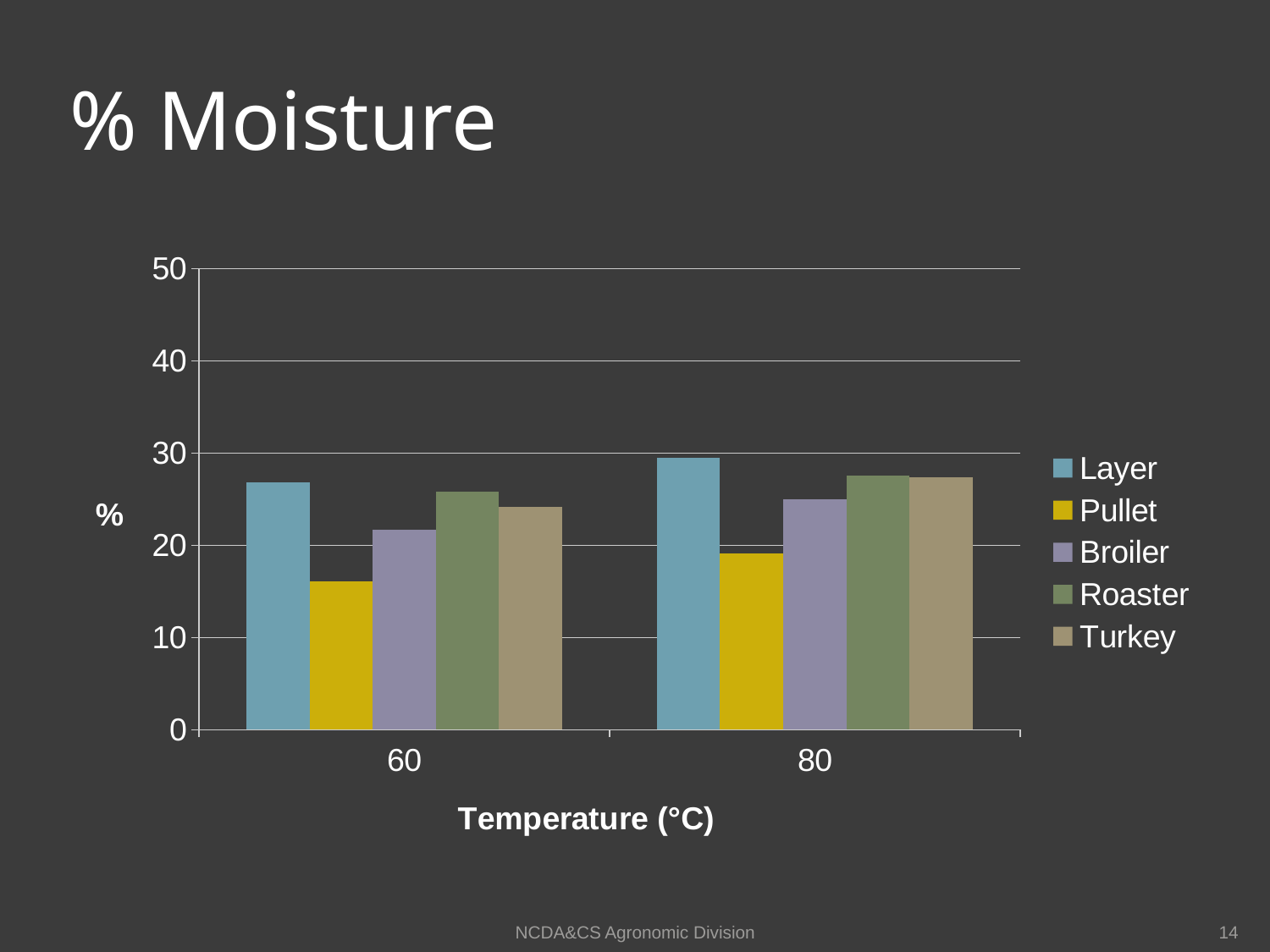
Which is larger, the Broiler value at 60 °C or the Broiler value at 80 °C? 80 °C What kind of chart is shown on the slide? bar chart Is the value for Pullet at 60 °C greater or less than 20? less How many temperature categories are shown on the x axis? 2 What is the label on the x axis of the chart? Temperature (°C) Which series has the lowest value at 60 °C? Pullet Which series has the highest value at 80 °C? Layer How many series does the legend list? 5 Does the Pullet value rise or fall from 60 °C to 80 °C? rise Which series has the lowest value at 80 °C? Pullet Is the value for Broiler at 80 °C greater or less than 20? greater